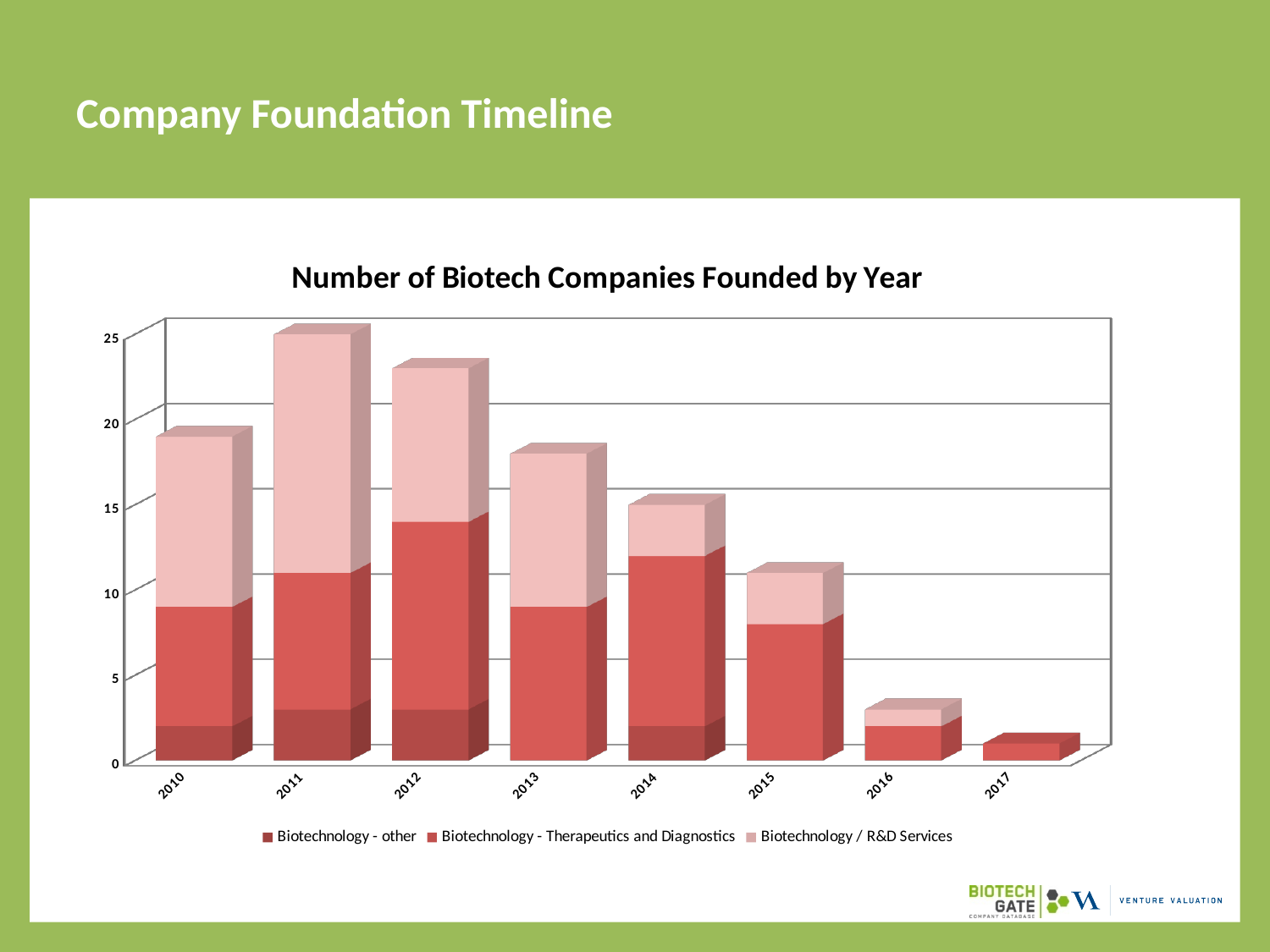
How many years are shown on the x axis? 8 What kind of chart is shown on the slide? Stacked bar chart Is the total for 2014 greater or less than 20? less From 2011 to 2017, do the total bar heights rise or fall? fall Is the total for 2011 greater or less than 20? greater Which year has the highest total number of biotech companies founded? 2011 Is the total for 2010 greater or less than 15? greater Which year has a larger total, 2012 or 2013? 2012 How many series does the legend list? 3 Which year has the lowest total number of biotech companies founded? 2017 What is the title of the chart? Number of Biotech Companies Founded by Year